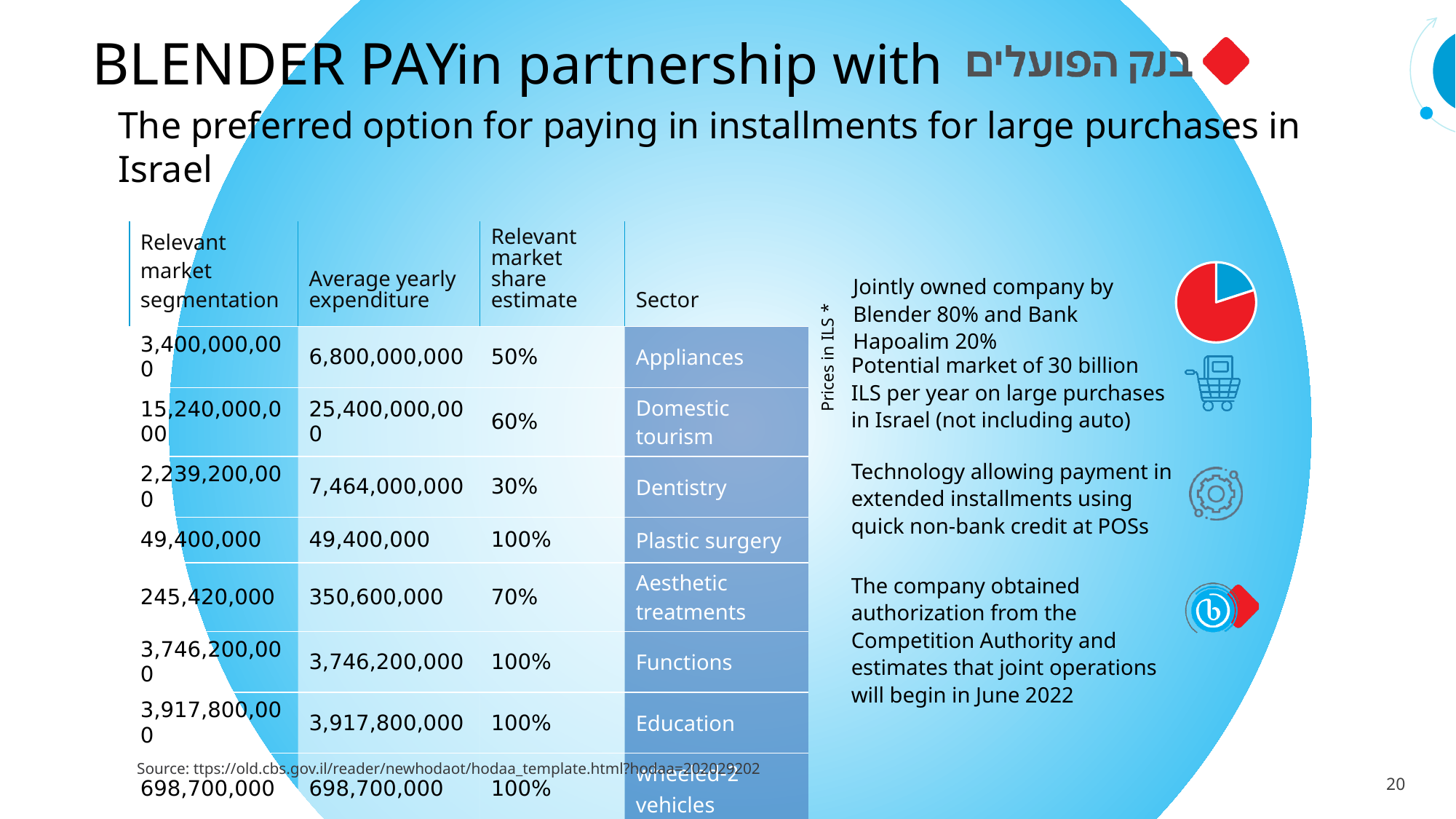
According to the text beside the small pie chart, what share of the jointly owned company does Bank Hapoalim hold? 20% What kind of chart is the small chart at the top right of the slide, next to the text about the jointly owned company? pie chart What colour is the larger slice of the small pie chart next to the 'Jointly owned company' text? red How many slices does the small pie chart next to the 'Jointly owned company' text have? 2 In the small pie chart next to the 'Jointly owned company' text, which slice is larger, the red one or the blue one? red According to the text beside the small pie chart, what share of the jointly owned company does Blender hold? 80%